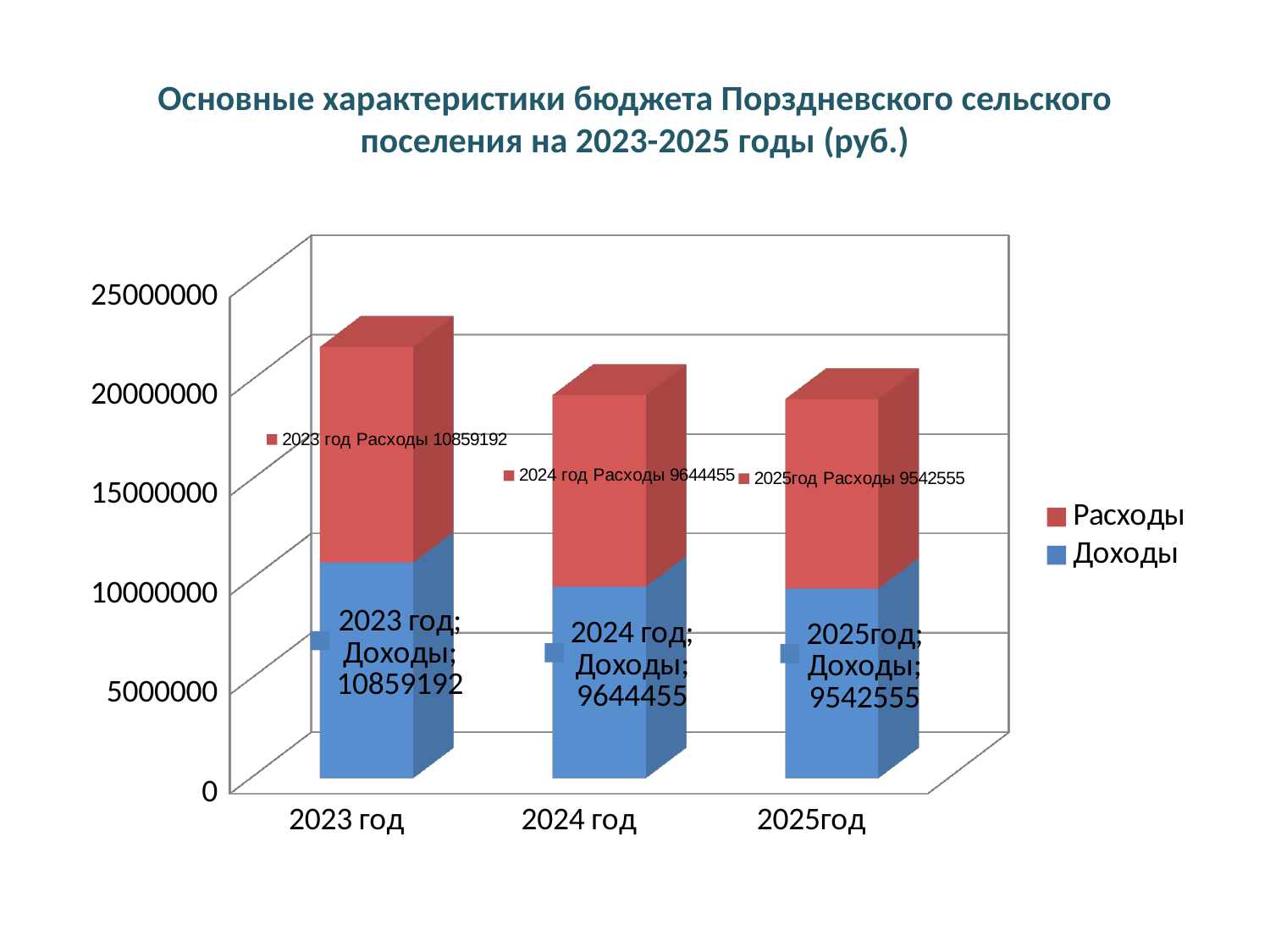
What kind of chart is shown on the slide? Stacked bar chart What is the value of Доходы for 2023 год? 10859192 What is the value of Доходы for 2025год? 9542555 Which is larger: Расходы for 2024 год or Расходы for 2025год? Расходы for 2024 год Which year has the lowest Расходы value? 2025год Which year has the highest Доходы value? 2023 год How many years are shown on the x axis? 3 Do the Доходы values rise or fall from 2023 год to 2025год? Fall How many series does the legend list? 2 What is the total of the stacked bar for 2023 год? 21718384 What is the difference between Доходы for 2023 год and Доходы for 2024 год? 1214737 What is the value of Расходы for 2024 год? 9644455